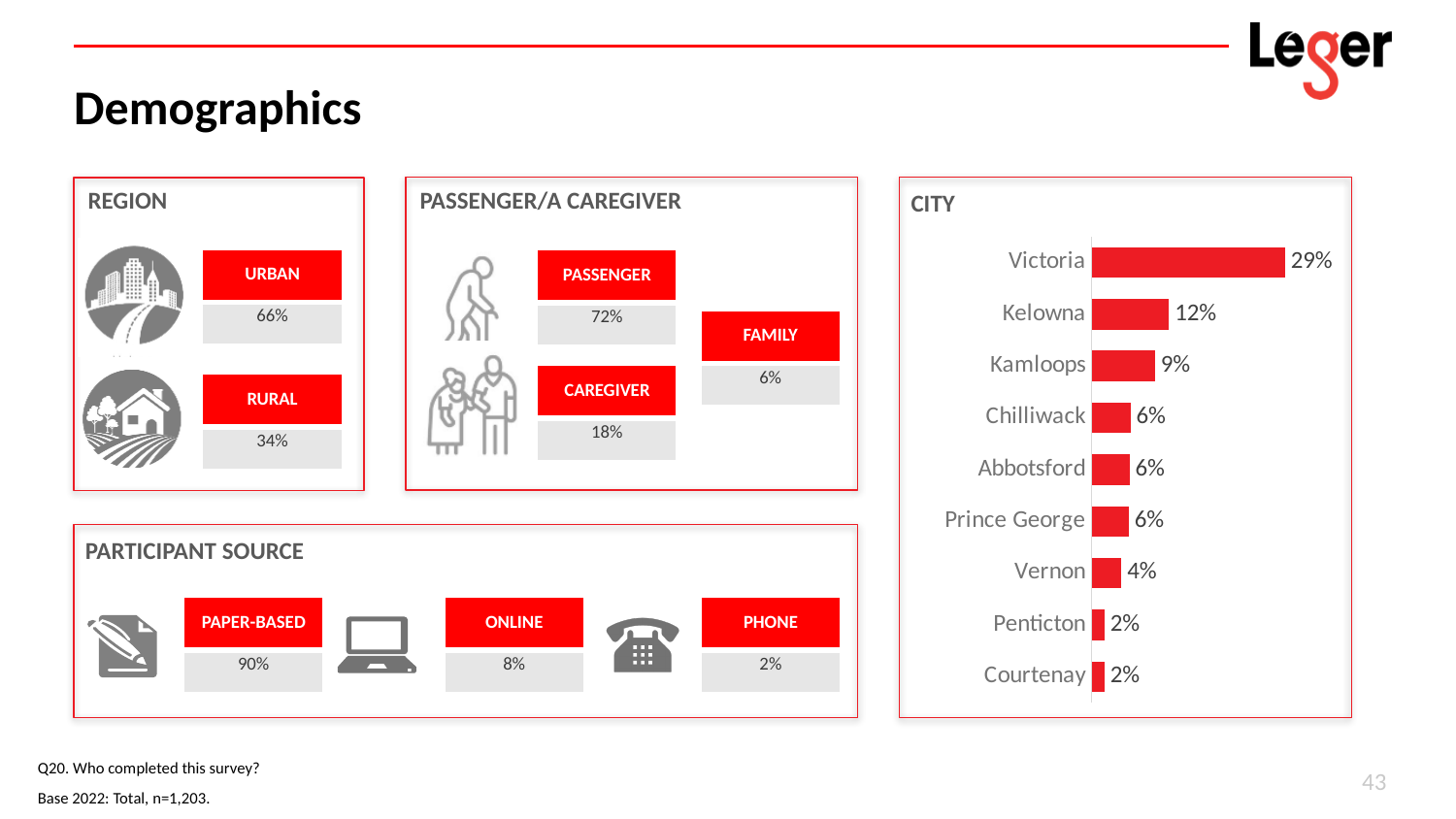
In the CITY chart, which is larger, the value for Kelowna or the value for Chilliwack? Kelowna In the CITY chart, which city has the highest value? Victoria In the CITY chart, what is the difference between the values for Kamloops and Vernon? 5% How many cities are shown in the CITY chart? 9 In the CITY chart, what is the value for Vernon? 4% In the CITY chart, what is the difference between the values for Victoria and Kelowna? 17% In the CITY chart, what is the value for Victoria? 29% In the CITY chart, what is the value for Kamloops? 9% What kind of chart is the CITY chart? Bar chart In the CITY chart, what is the value for Prince George? 6% What is the title of the bar chart on the right of the slide? CITY In the CITY chart, what is the value for Kelowna? 12%